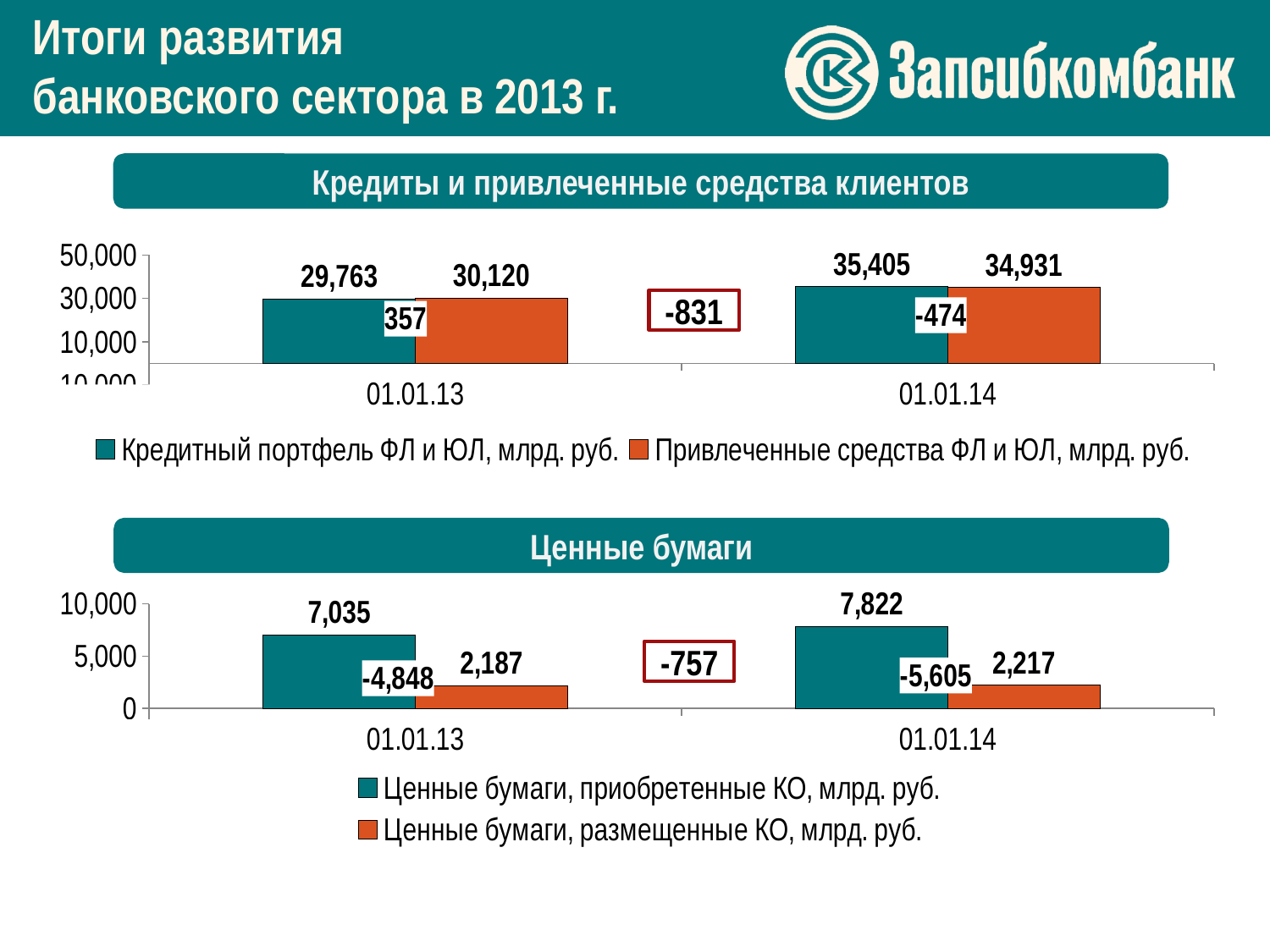
In the chart 'Кредиты и привлеченные средства клиентов', what is the value of 'Привлеченные средства ФЛ и ЮЛ, млрд. руб.' on 01.01.13? 30,120 How many series does the legend of the chart 'Кредиты и привлеченные средства клиентов' list? 2 In the chart 'Ценные бумаги', what is the value of 'Ценные бумаги, приобретенные КО, млрд. руб.' on 01.01.14? 7,822 In the chart 'Ценные бумаги', what is the difference between 'Ценные бумаги, приобретенные КО' and 'Ценные бумаги, размещенные КО' on 01.01.13? 4,848 In the chart 'Кредиты и привлеченные средства клиентов', what is the value of 'Кредитный портфель ФЛ и ЮЛ, млрд. руб.' on 01.01.13? 29,763 What type of chart is 'Ценные бумаги'? bar chart In the chart 'Кредиты и привлеченные средства клиентов', what is the value of 'Привлеченные средства ФЛ и ЮЛ, млрд. руб.' on 01.01.14? 34,931 How many dates are shown on the x axis of the chart 'Ценные бумаги'? 2 In the chart 'Ценные бумаги', what is the value of 'Ценные бумаги, размещенные КО, млрд. руб.' on 01.01.13? 2,187 In the chart 'Кредиты и привлеченные средства клиентов', by how much did 'Кредитный портфель ФЛ и ЮЛ, млрд. руб.' increase from 01.01.13 to 01.01.14? 5,642 In the chart 'Кредиты и привлеченные средства клиентов', does 'Кредитный портфель ФЛ и ЮЛ' rise or fall from 01.01.13 to 01.01.14? rise In the chart 'Ценные бумаги', which series has the larger value on 01.01.14: 'Ценные бумаги, приобретенные КО' or 'Ценные бумаги, размещенные КО'? Ценные бумаги, приобретенные КО